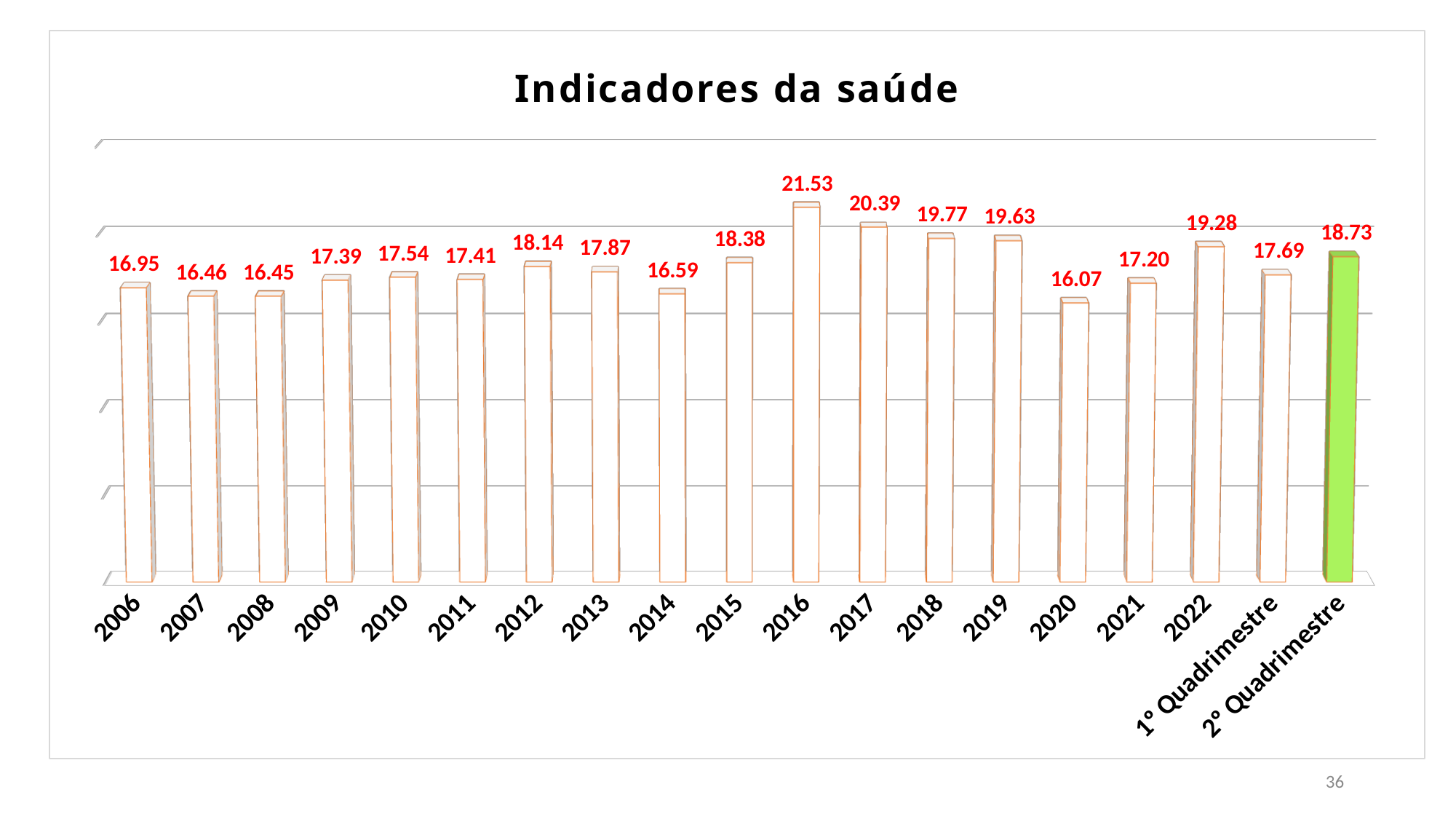
Do the values rise or fall from 2016 to 2020? Fall What kind of chart is shown on the slide? Bar chart How many categories are shown on the x axis? 19 What is the value for 2° Quadrimestre? 18.73 What is the difference between the values for 2016 and 2020? 5.46 Which category has the highest value? 2016 What is the title of the chart? Indicadores da saúde What is the value for 2020? 16.07 What is the value for 2016? 21.53 What is the difference between the values for 2° Quadrimestre and 1° Quadrimestre? 1.04 Which category has the lowest value? 2020 Which is larger, the value for 2017 or the value for 2018? 2017